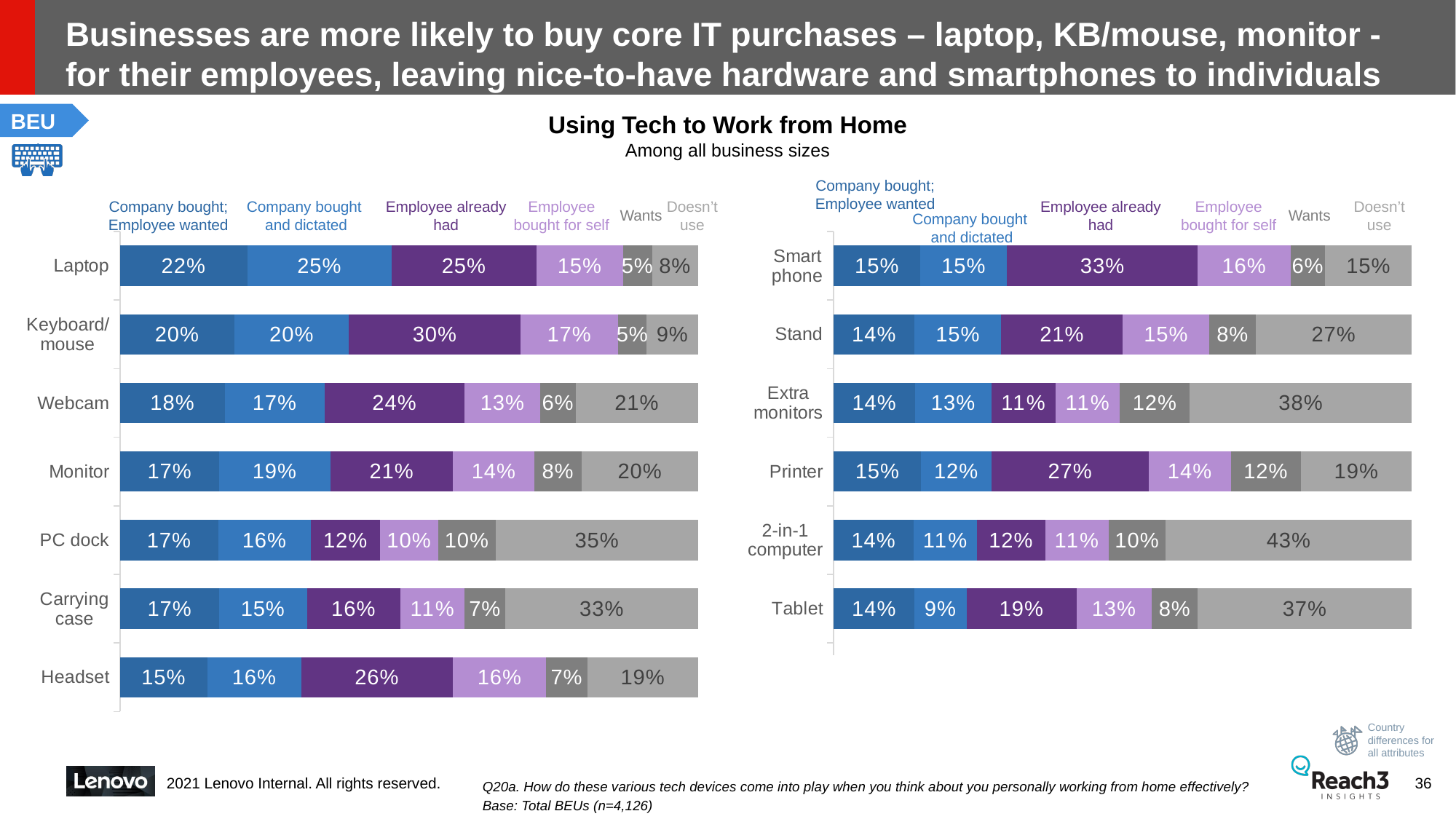
In the left chart, which device has the lowest 'Doesn't use' percentage? Laptop In the right chart, which device has the highest 'Doesn't use' percentage? 2-in-1 computer In the left chart, what is the difference between the 'Employee already had' values for Keyboard/mouse and PC dock? 18% In the right chart, what is the 'Employee already had' value for Smart phone? 33% In the left chart, what is the 'Doesn't use' value for PC dock? 35% In the left chart, what percentage of respondents said their company bought and dictated the laptop? 25% How many devices are listed in the left chart? 7 In the right chart, which is larger: the 'Employee already had' value for Printer or for Tablet? Printer What is the title of the charts on this slide? Using Tech to Work from Home How many devices are listed in the right chart? 6 How many series does each chart show? 6 What type of chart is used on this slide? Stacked bar chart